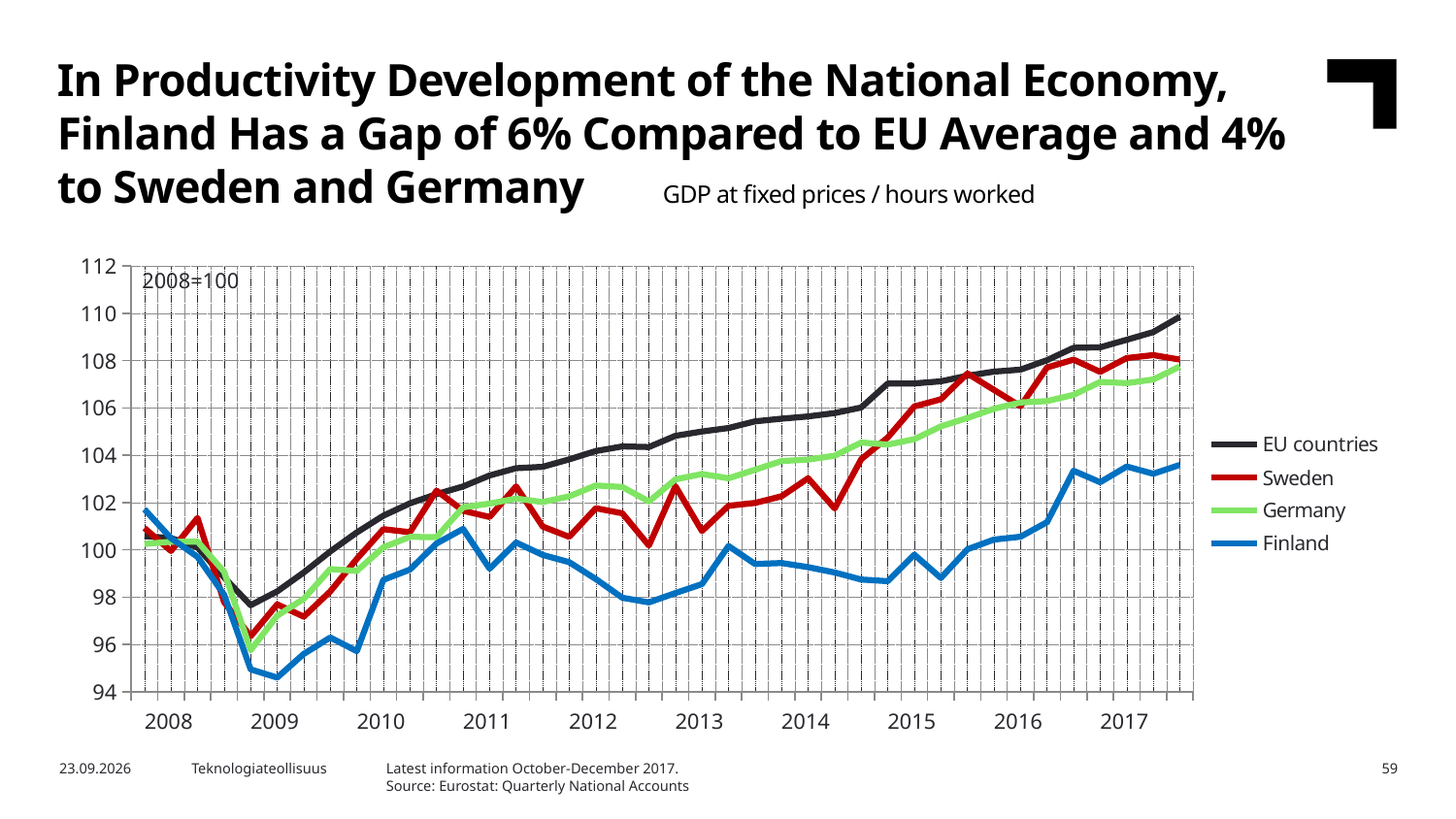
Which series dropped to the lowest level during 2009? Finland Is Finland's lowest value in 2009 greater or less than 96? less Which series has the lowest value at the end of 2017? Finland What kind of chart is shown on the slide? line chart Which series are listed in the legend? EU countries, Sweden, Germany, Finland How many series does the legend list? 4 Is the value for Germany at the end of 2017 greater or less than 106? greater Which series has the highest value at the end of 2017? EU countries Does the EU countries line rise or fall from 2010 to 2017? rise At the end of 2017, which is larger: the value for Sweden or the value for Finland? Sweden What base-year annotation is printed inside the chart area? 2008=100 Is the value for EU countries at the end of 2017 greater or less than 108? greater